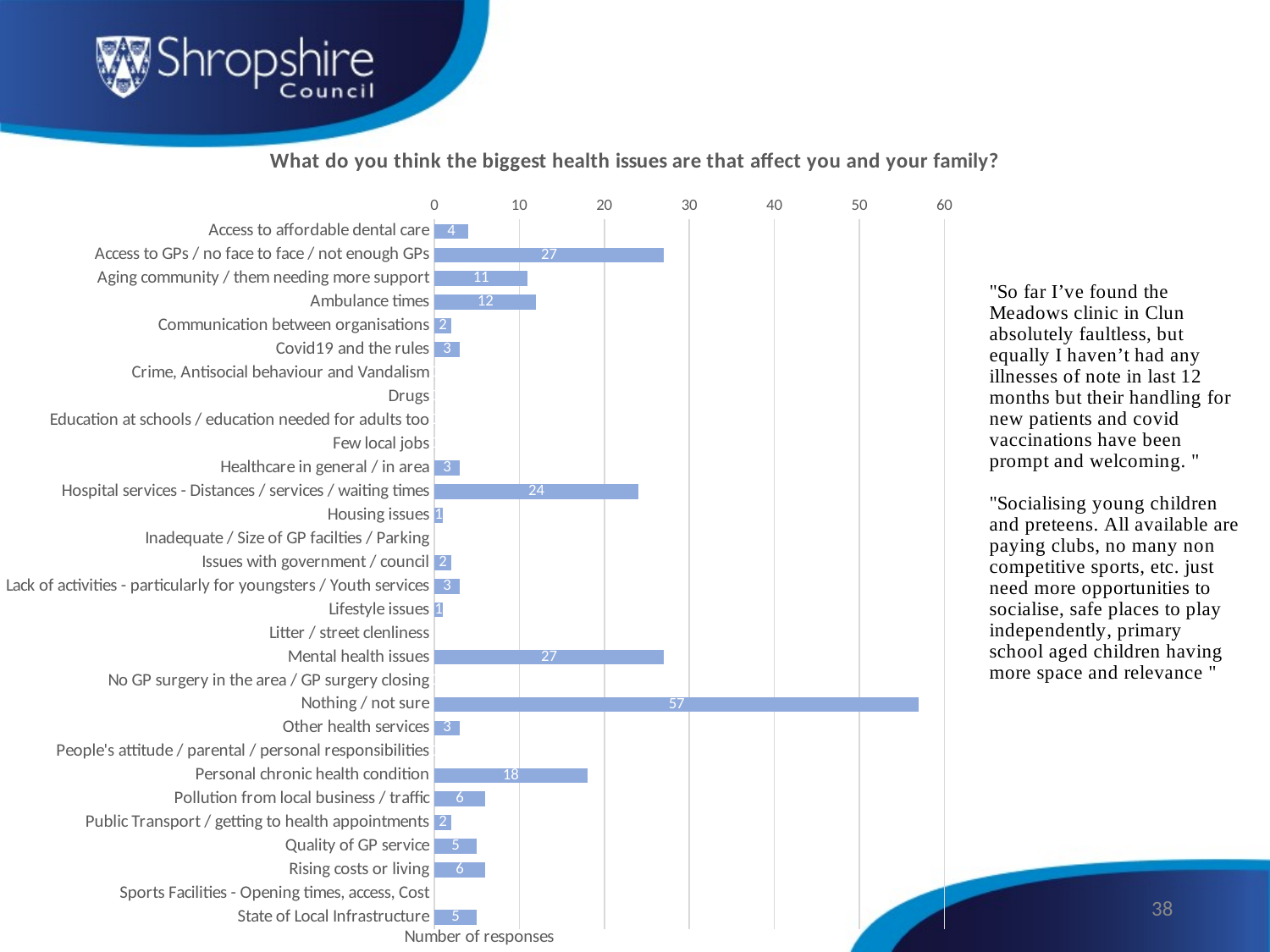
How many responses are shown for 'Hospital services - Distances / services / waiting times'? 24 What type of chart is shown on the slide? Bar chart What is the number of responses for 'Nothing / not sure'? 57 What value is shown for 'Personal chronic health condition'? 18 What is the number of responses for 'Ambulance times'? 12 Is the value for 'Nothing / not sure' greater or less than 50? greater Which category has the highest number of responses? Nothing / not sure What is the difference in responses between 'Nothing / not sure' and 'Mental health issues'? 30 How many categories are listed on the chart? 30 What is the label on the horizontal axis of the chart? Number of responses What is the difference between 'Hospital services - Distances / services / waiting times' and 'Personal chronic health condition'? 6 Which has more responses: 'Ambulance times' or 'Aging community / them needing more support'? Ambulance times